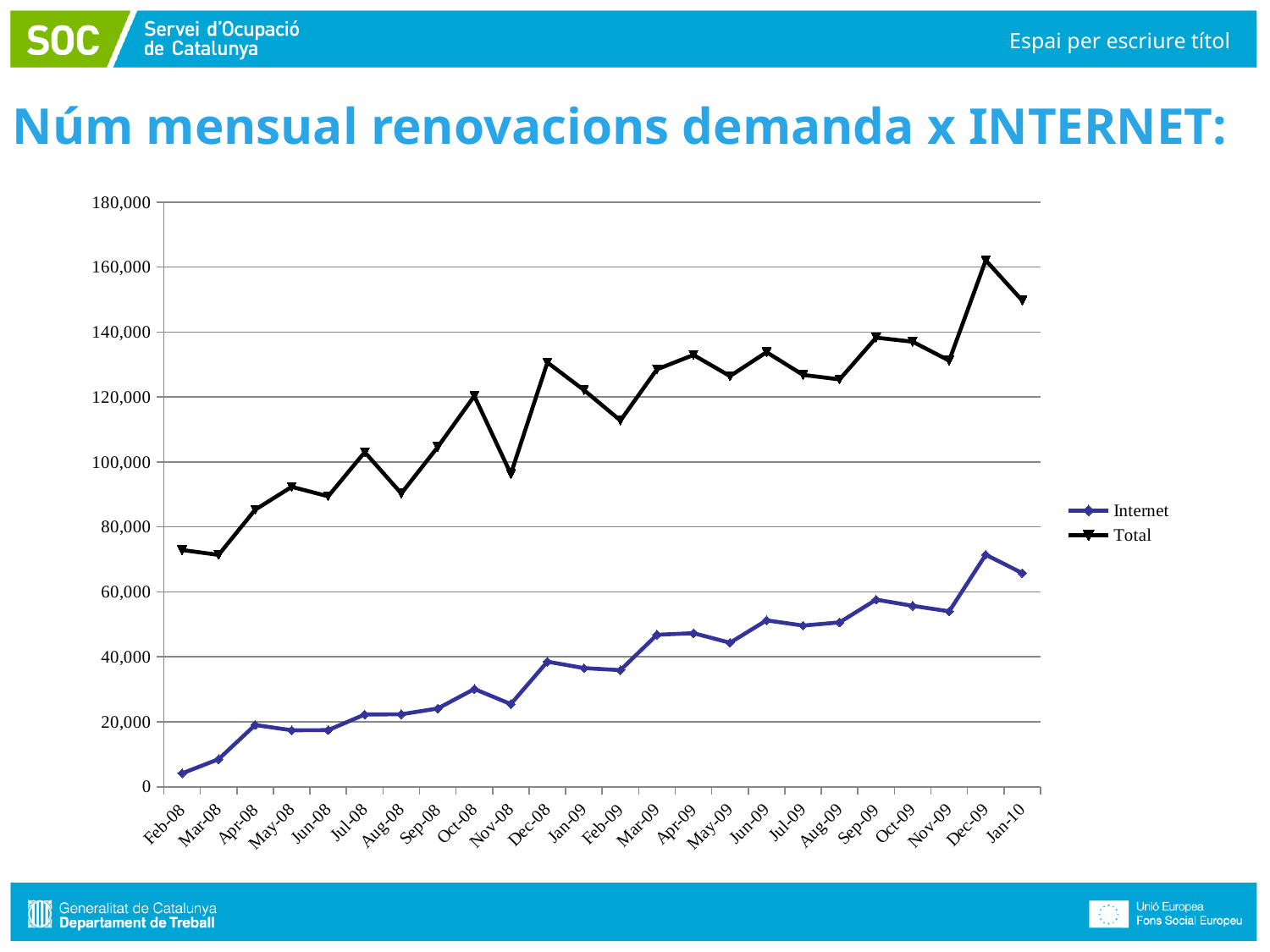
In which month is the Internet series at its lowest value? Feb-08 Is the Total value for Feb-08 greater or less than 80,000? less What kind of chart is shown on the slide? line chart What is the title of the chart on the slide? Núm mensual renovacions demanda x INTERNET: How many months are plotted along the x axis? 24 Which is larger in Oct-08, the Total value or the Internet value? Total In which month does the Internet series reach its highest value? Dec-09 In which month does the Total series reach its highest value? Dec-09 Is the Total value for Dec-09 greater or less than 140,000? greater Is the Internet value for Feb-08 greater or less than 20,000? less Does the Internet series generally rise or fall from Feb-08 to Jan-10? rise How many series does the legend list? 2